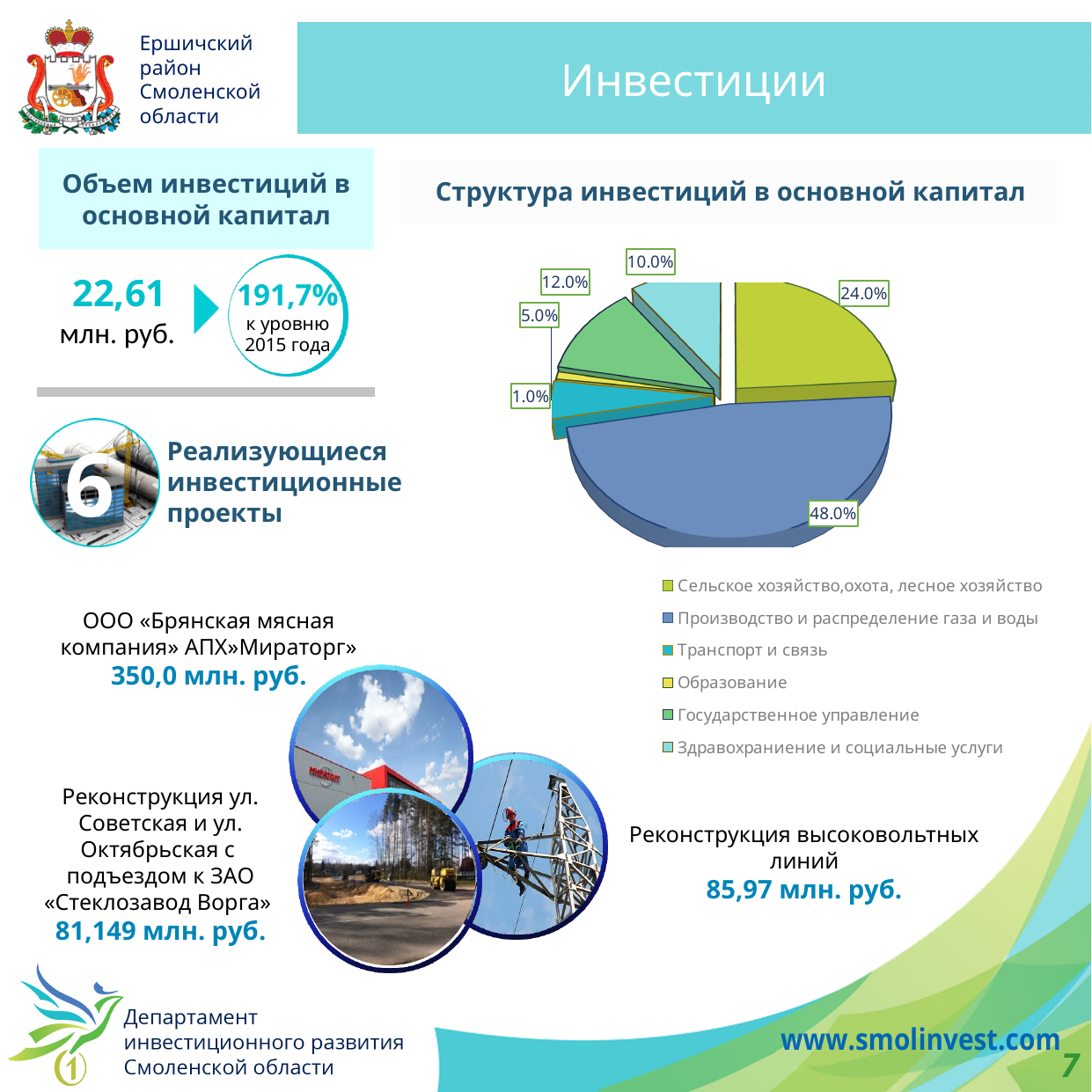
In the pie chart «Структура инвестиций в основной капитал», how many categories does the legend list? 6 In the pie chart «Структура инвестиций в основной капитал», what share is labelled for «Государственное управление»? 12.0% What kind of chart is shown under the title «Структура инвестиций в основной капитал»? pie chart In the pie chart «Структура инвестиций в основной капитал», which share is larger: «Государственное управление» or «Здравоохранение и социальные услуги»? Государственное управление In the pie chart «Структура инвестиций в основной капитал», what share is labelled for «Образование»? 1.0% In the pie chart «Структура инвестиций в основной капитал», which category has the largest share? Производство и распределение газа и воды In the pie chart «Структура инвестиций в основной капитал», which category has the smallest share? Образование In the pie chart «Структура инвестиций в основной капитал», what colour is the slice for «Производство и распределение газа и воды»? blue In the pie chart «Структура инвестиций в основной капитал», what share is labelled for «Производство и распределение газа и воды»? 48.0% In the pie chart «Структура инвестиций в основной капитал», what share is labelled for «Сельское хозяйство,охота, лесное хозяйство»? 24.0% In the pie chart «Структура инвестиций в основной капитал», what share is labelled for «Здравоохранение и социальные услуги»? 10.0% In the pie chart «Структура инвестиций в основной капитал», what is the difference in percentage points between «Производство и распределение газа и воды» and «Сельское хозяйство,охота, лесное хозяйство»? 24.0%